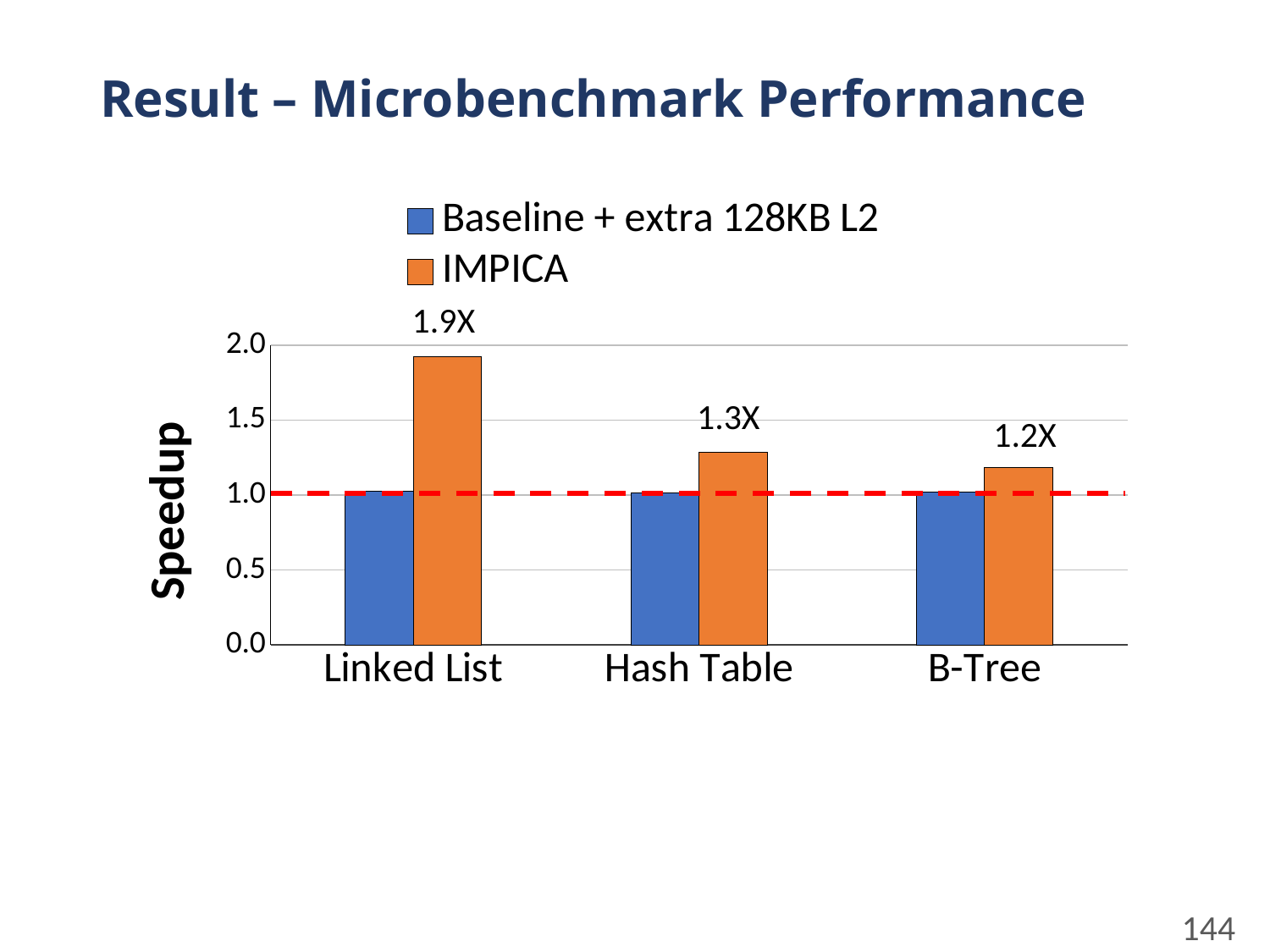
What is the IMPICA speedup for Hash Table? 1.3X How many benchmarks are shown on the x axis? 3 How many series does the legend list? 2 Is the Baseline + extra 128KB L2 value for Linked List greater or less than 1.5? less What is the difference between the IMPICA speedup for Linked List and for B-Tree? 0.7X Do the IMPICA speedup values rise or fall from Linked List to B-Tree? fall Which has a larger IMPICA speedup, Hash Table or B-Tree? Hash Table What is the IMPICA speedup for Linked List? 1.9X What is the IMPICA speedup for B-Tree? 1.2X What kind of chart is shown on the slide? bar chart Which benchmark has the highest IMPICA speedup? Linked List Which benchmark has the lowest IMPICA speedup? B-Tree